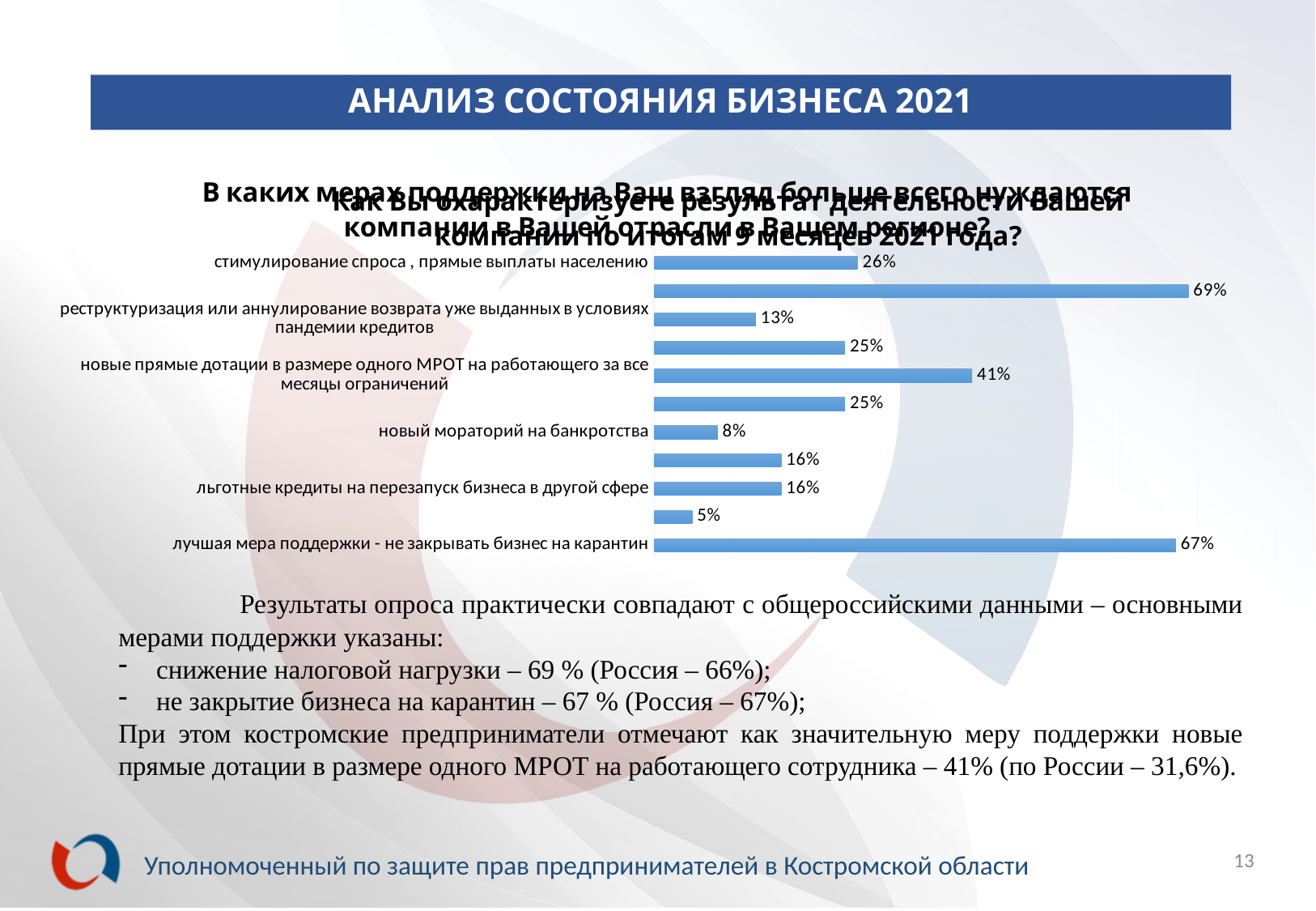
What value is shown for "новый мораторий на банкротства"? 8% What is the highest value shown on the chart? 69% What value is shown for "новые прямые дотации в размере одного МРОТ на работающего за все месяцы ограничений"? 41% What value is shown for "лучшая мера поддержки - не закрывать бизнес на карантин"? 67% What value is shown for "стимулирование спроса , прямые выплаты населению"? 26% What is the difference between the values for "лучшая мера поддержки - не закрывать бизнес на карантин" and "новые прямые дотации в размере одного МРОТ на работающего за все месяцы ограничений"? 26% Which is larger: the value for "стимулирование спроса , прямые выплаты населению" or the value for "реструктуризация или аннулирование возврата уже выданных в условиях пандемии кредитов"? стимулирование спроса , прямые выплаты населению What kind of chart is shown on the slide? bar chart What value is shown for "льготные кредиты на перезапуск бизнеса в другой сфере"? 16% What value is shown for "реструктуризация или аннулирование возврата уже выданных в условиях пандемии кредитов"? 13% What is the lowest value shown on the chart? 5% How many bars are plotted on the chart? 11